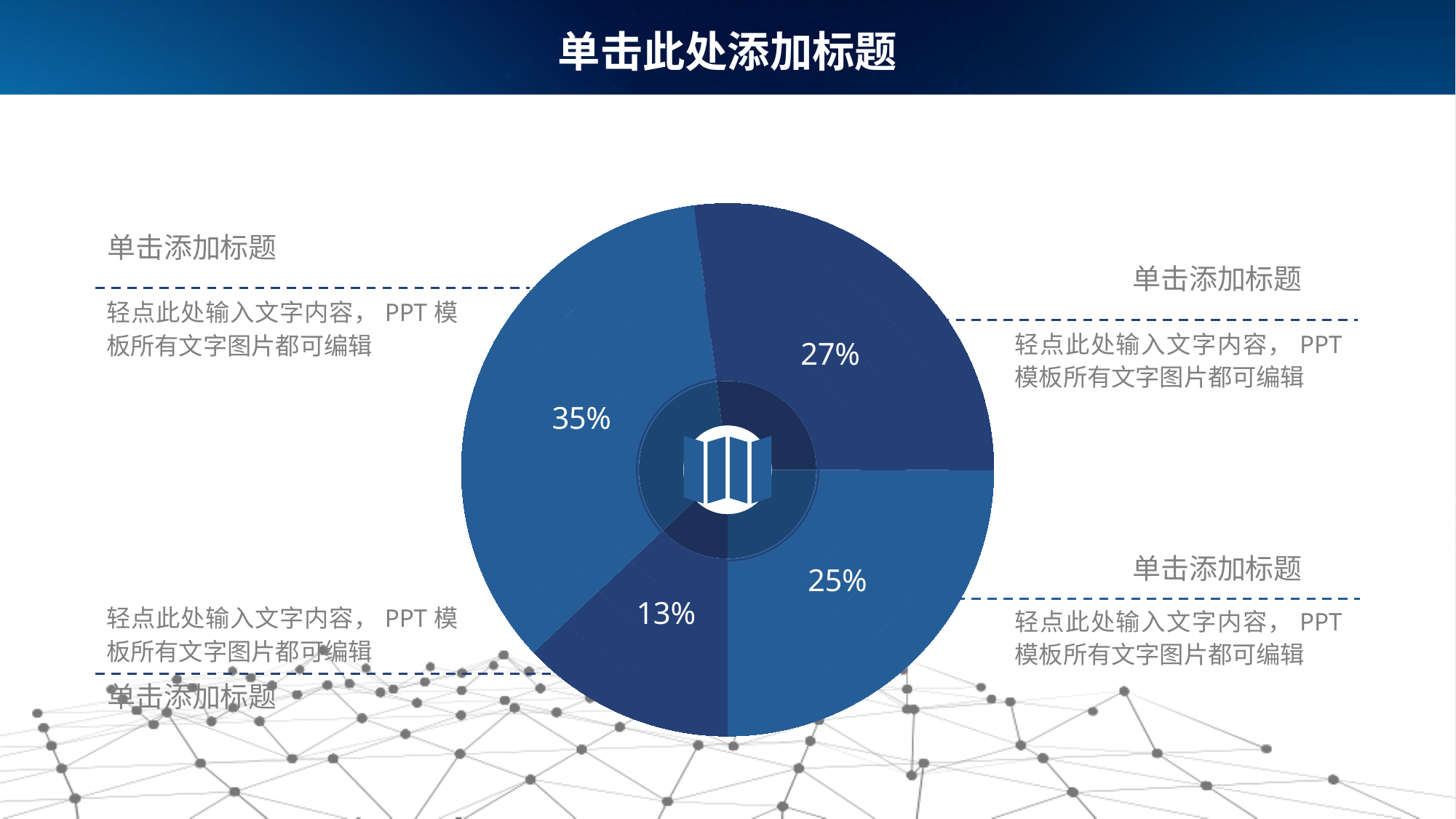
What kind of chart is shown on the slide? pie chart What is the difference between the 27% slice and the 25% slice? 2% How many slices does the pie chart have? 4 Which is larger, the left slice or the bottom slice of the pie chart? the left slice (35%) What percentage is shown on the left slice of the pie chart? 35% What percentage is shown on the bottom slice of the pie chart? 13% What is the value of the largest slice in the pie chart? 35% What is the value of the smallest slice in the pie chart? 13% What percentage is shown on the bottom-right slice of the pie chart? 25% What percentage is shown on the top-right slice of the pie chart? 27% What is the difference between the largest slice (35%) and the smallest slice (13%)? 22% What do the four slice percentages in the pie chart add up to? 100%